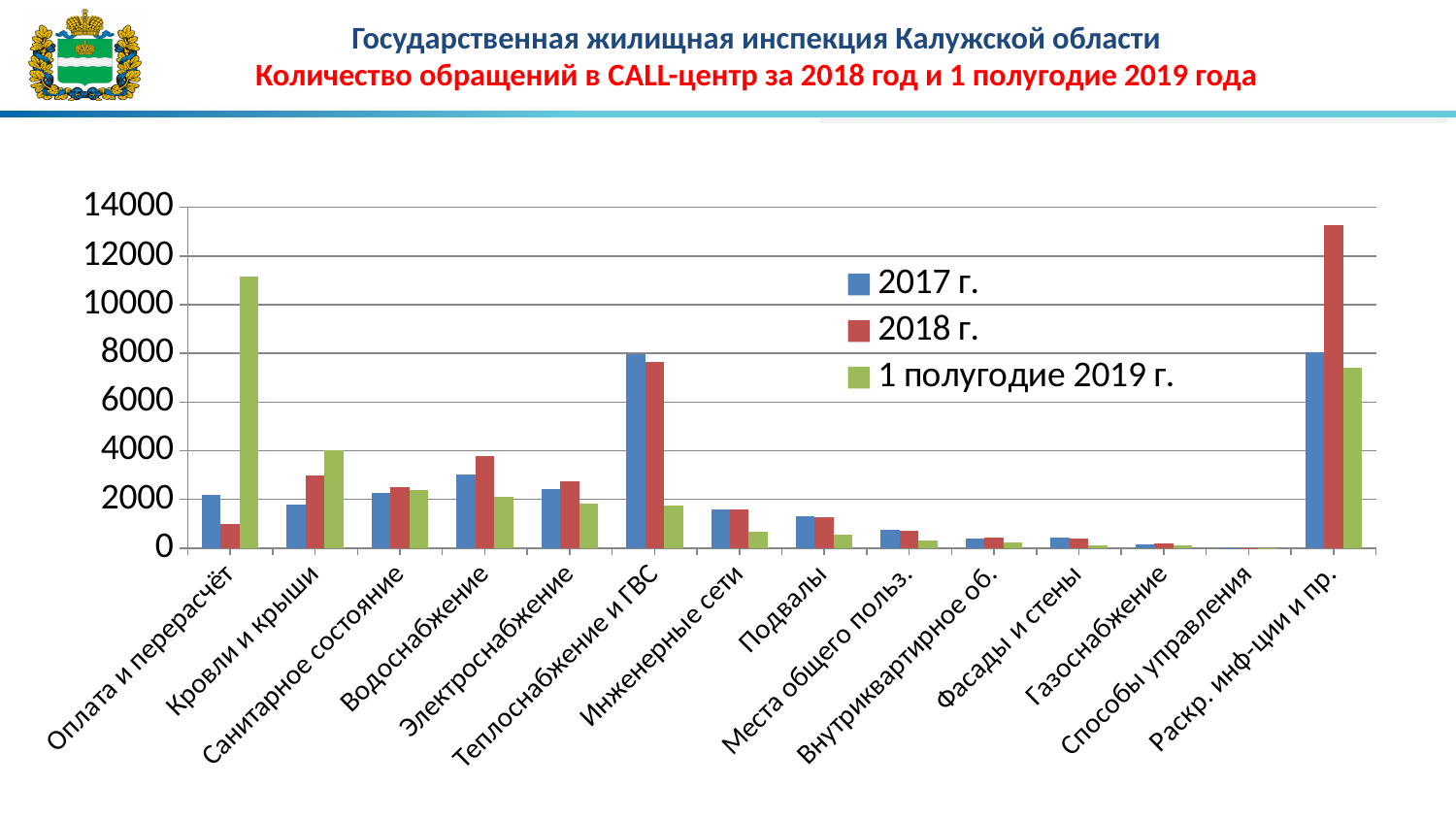
Which category has the highest value for the 1 полугодие 2019 г. series? Оплата и перерасчёт Is the 2018 г. value for Раскр. инф-ции и пр. greater or less than 12000? greater How many categories are shown on the x axis? 14 What are the three entries listed in the chart legend? 2017 г., 2018 г., 1 полугодие 2019 г. Is the 2018 г. value for Теплоснабжение и ГВС greater or less than 6000? greater How many series does the legend list? 3 Which category has the highest value for the 2018 г. series? Раскр. инф-ции и пр. What kind of chart is shown on the slide? bar chart Is the 1 полугодие 2019 г. value for Оплата и перерасчёт greater or less than 10000? greater For Оплата и перерасчёт, which is larger: the 2018 г. value or the 1 полугодие 2019 г. value? 1 полугодие 2019 г. For Водоснабжение, which is larger: the 2018 г. value or the 1 полугодие 2019 г. value? 2018 г.